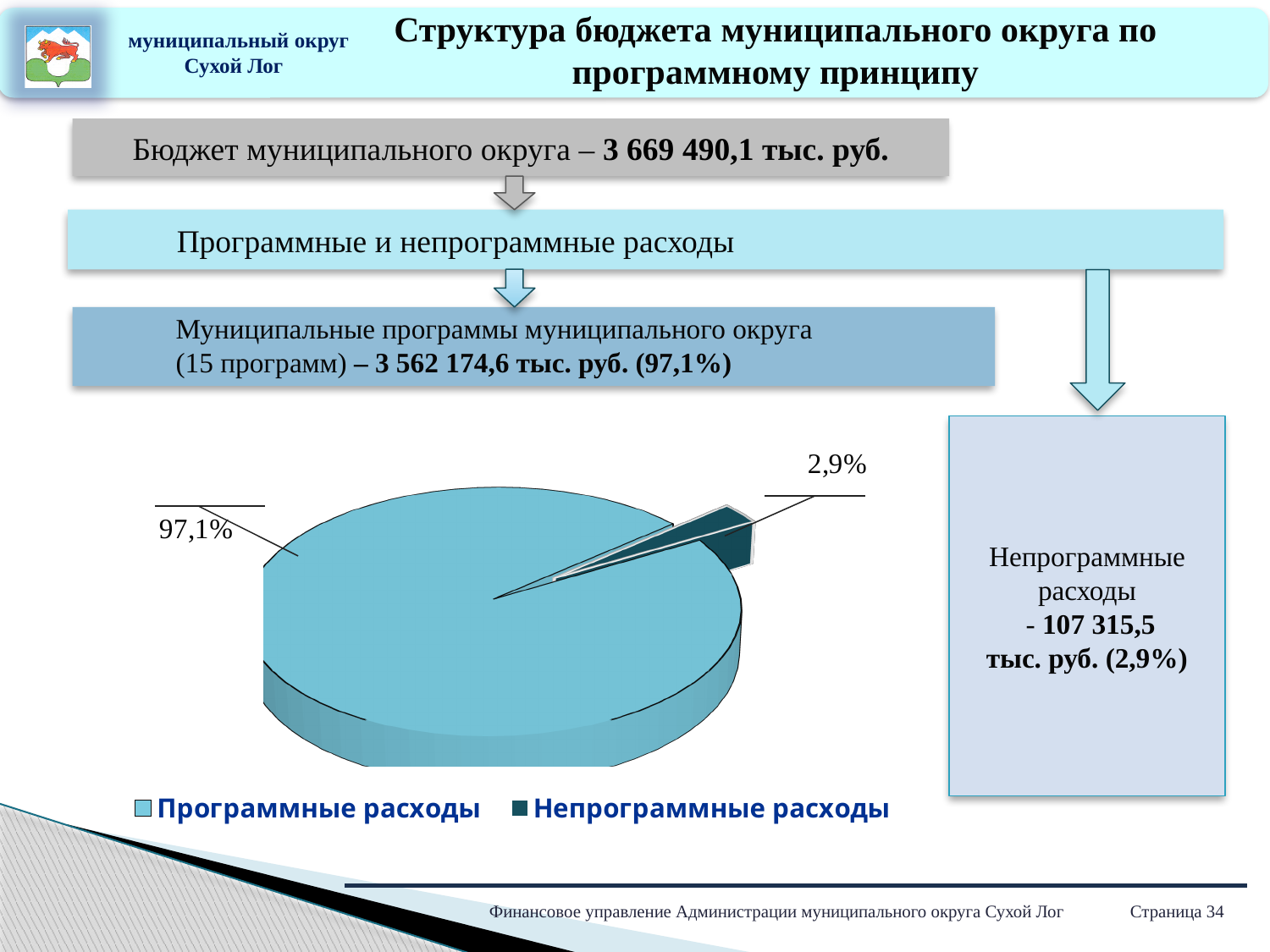
Which slice of the pie is the largest? Программные расходы Which is larger, the share for Программные расходы or for Непрограммные расходы? Программные расходы Which legend entry is shown in the darker colour? Непрограммные расходы What share of the pie does Программные расходы take? 97,1% How many entries does the legend list? 2 What is the difference in percentage points between the Программные расходы and Непрограммные расходы slices? 94,2 What is the total of the two pie slice percentages? 100% How many slices does the pie chart have? 2 Which slice of the pie is the smallest? Непрограммные расходы What share of the pie does Непрограммные расходы take? 2,9% What kind of chart is shown on the slide? pie chart